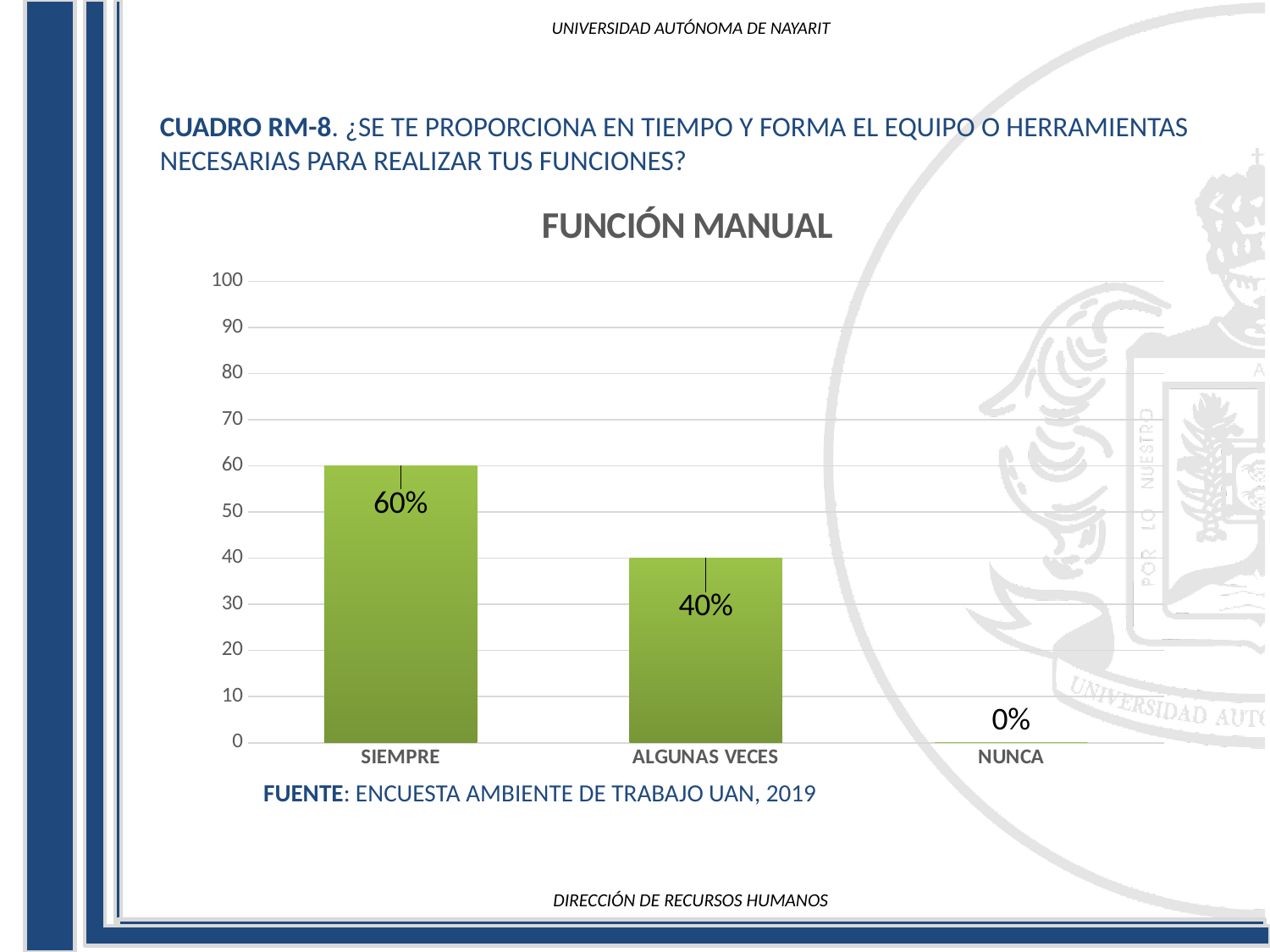
What is the value for ALGUNAS VECES? 40% Which is larger, the value for SIEMPRE or the value for ALGUNAS VECES? SIEMPRE What is the title of the chart? FUNCIÓN MANUAL How many categories are shown on the x axis? 3 What is the difference between the values for SIEMPRE and ALGUNAS VECES? 20% Do the values rise or fall from left to right along the x axis? fall What kind of chart is shown? bar chart What is the value for NUNCA? 0% Is the value for SIEMPRE greater or less than 50? greater Which category has the lowest value? NUNCA Which category has the highest value? SIEMPRE What is the value for SIEMPRE? 60%